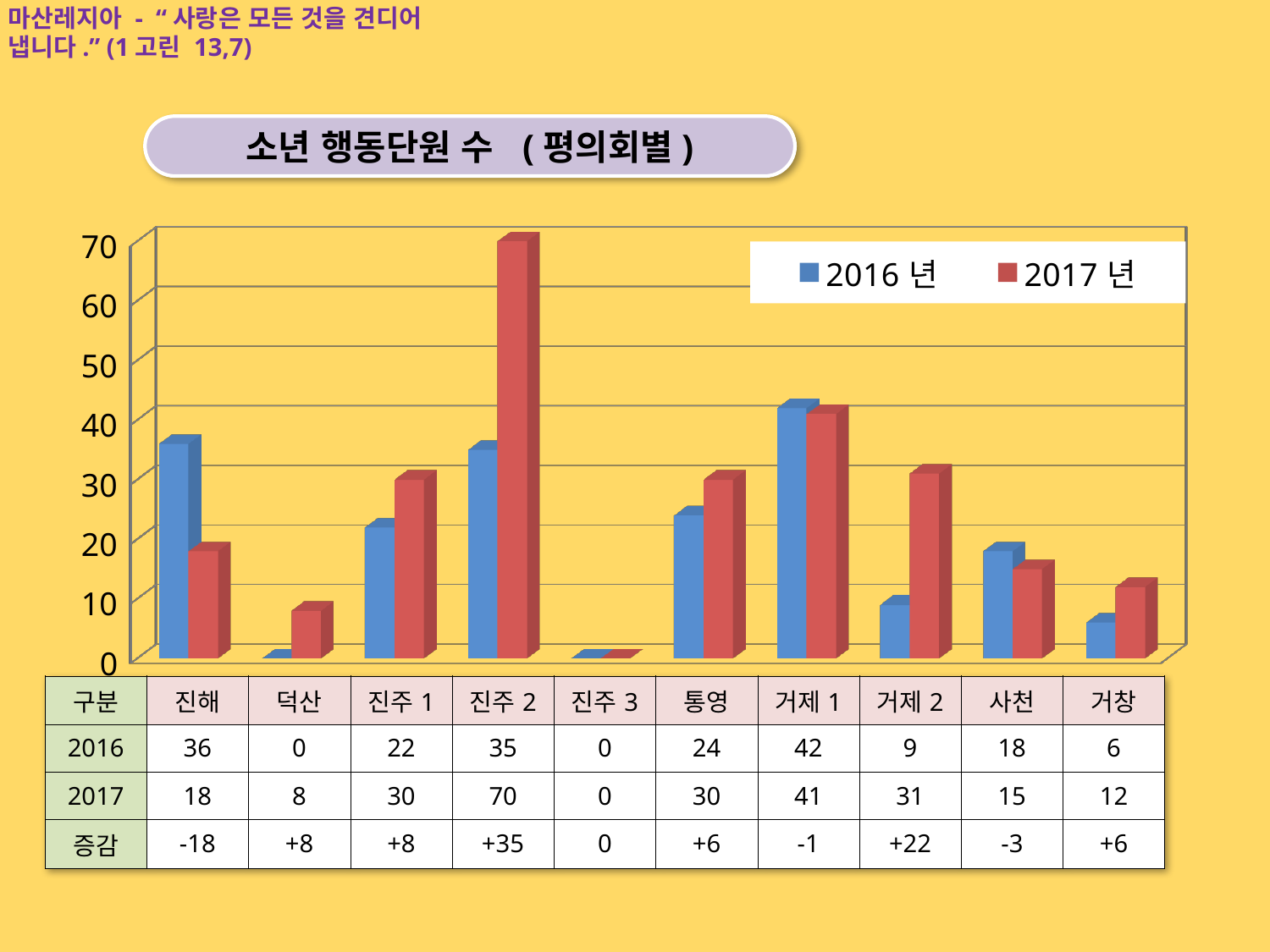
Which is larger for 진해, the 2016 년 value or the 2017 년 value? 2016 년 What is the 2017 년 value for 진주 2? 70 How many categories are shown on the x axis of the chart? 10 What is the difference between the 2017 년 and 2016 년 values for 거제 2? 22 What is the 2016 년 value for 거제 1? 42 Which category has the highest 2017 년 value? 진주 2 What is the title of the chart? 소년 행동단원 수 ( 평의회별 ) Which category has the highest 2016 년 value? 거제 1 What type of chart is shown on the slide? bar chart How many series does the legend list? 2 What is the 2017 년 value for 덕산? 8 Is the 2017 년 value for 진주 2 greater or less than 60? greater